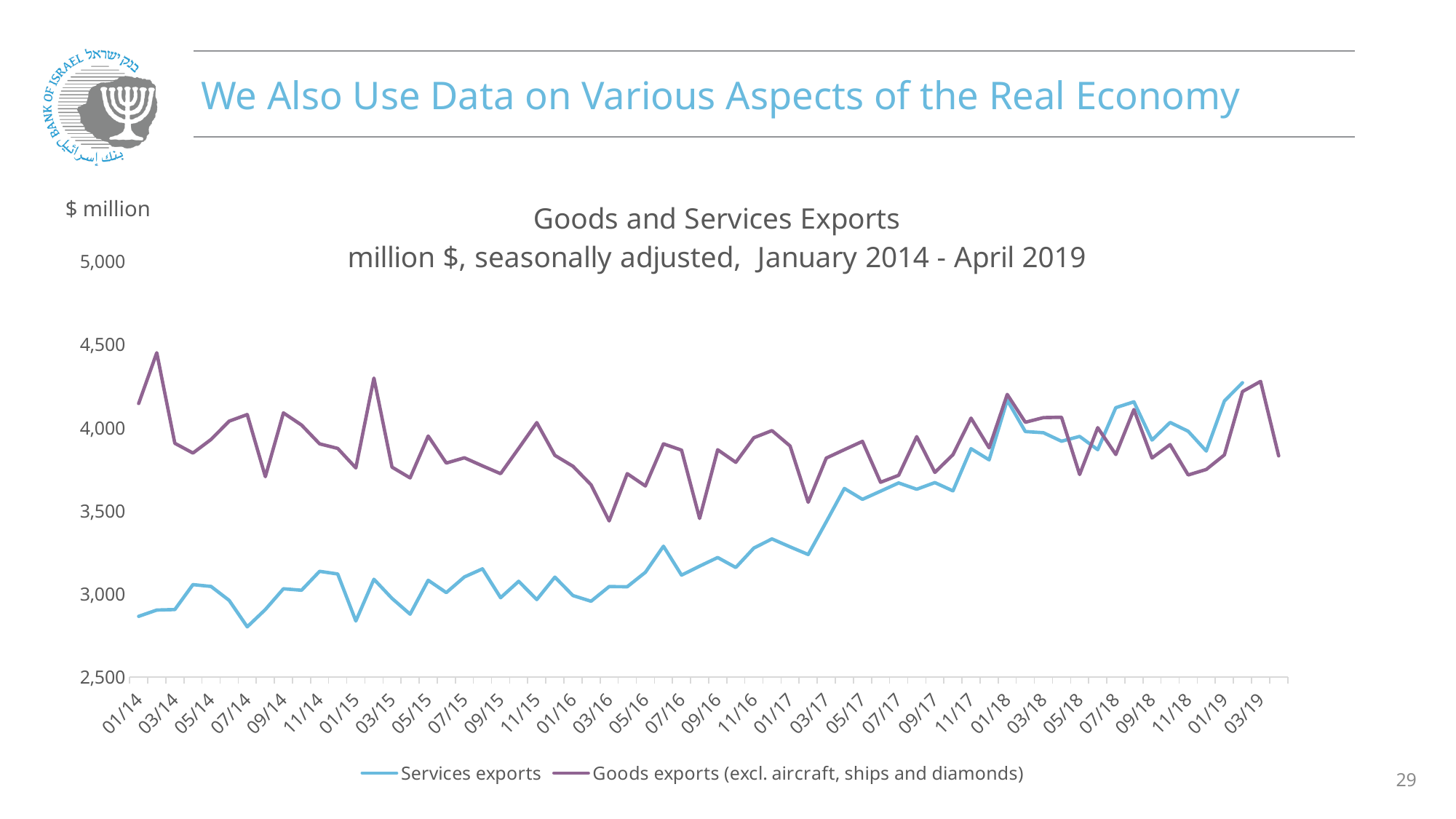
How many series does the legend list? 2 Do Services exports generally rise or fall from 01/14 to 03/19? rise What kind of chart is shown on the slide? line chart At 01/16, which series has the larger value, Services exports or Goods exports? Goods exports What is the title of the chart? Goods and Services Exports Which series is drawn in purple according to the legend? Goods exports (excl. aircraft, ships and diamonds) Is the value for Services exports at 01/19 greater or less than 4,000? greater Is the value for Goods exports at 03/16 greater or less than 3,500? less Is the value for Services exports at 01/14 greater or less than 3,000? less At 01/19, which series has the larger value, Services exports or Goods exports? Services exports